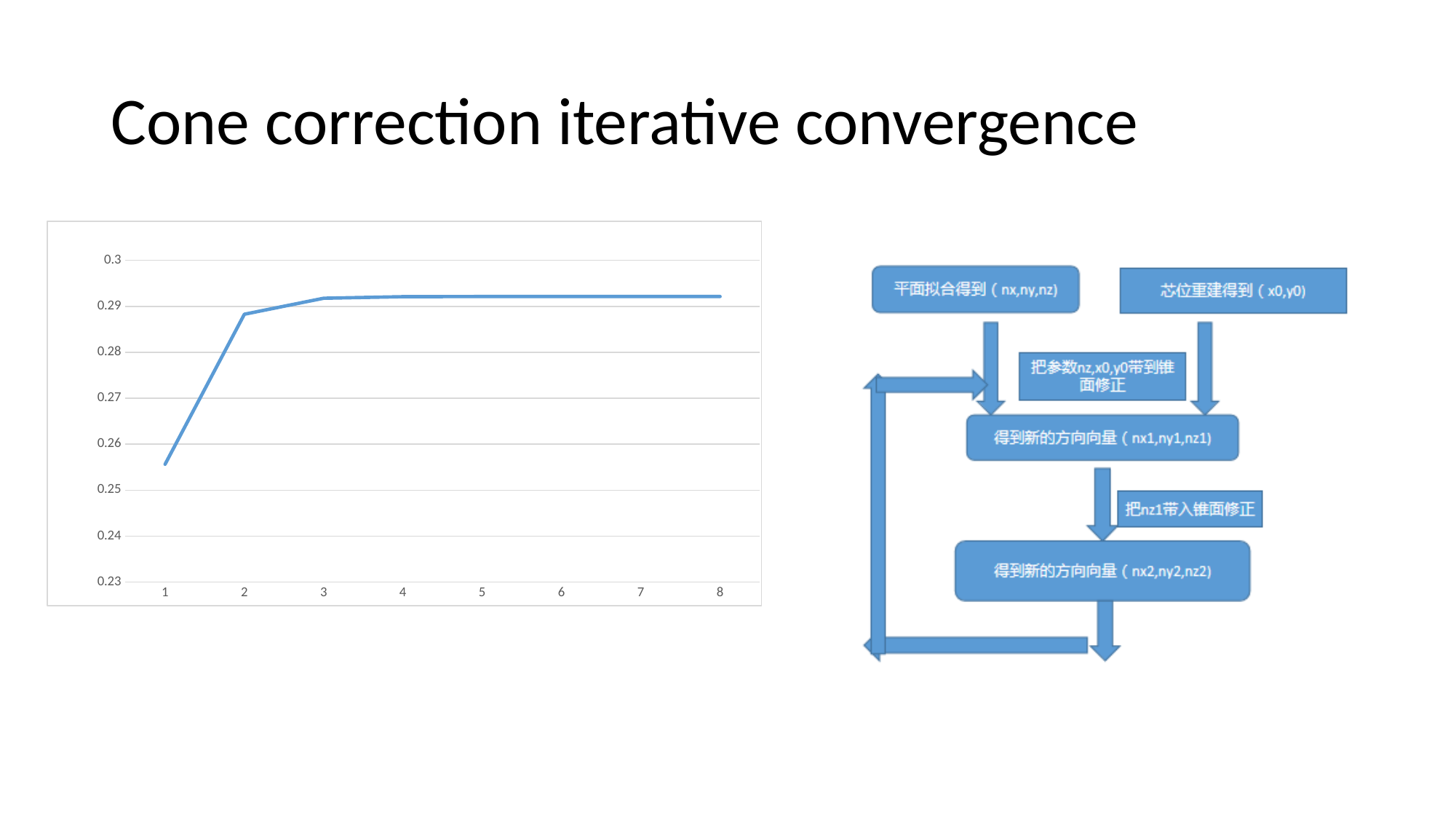
Is the value at x = 1 greater or less than 0.26? less Which x-axis point has the lowest value in the line chart? 1 What is the lowest tick label shown on the y axis of the line chart? 0.23 What colour is the line in the line chart? blue Is the value at x = 5 greater or less than 0.3? less Is the value at x = 1 greater or less than 0.25? greater Which has the larger value in the line chart, x = 1 or x = 2? 2 Do the values in the line chart rise or fall from x = 1 to x = 3? rise How many points are plotted along the x axis of the line chart? 8 What kind of chart is shown on the left of the slide? line chart